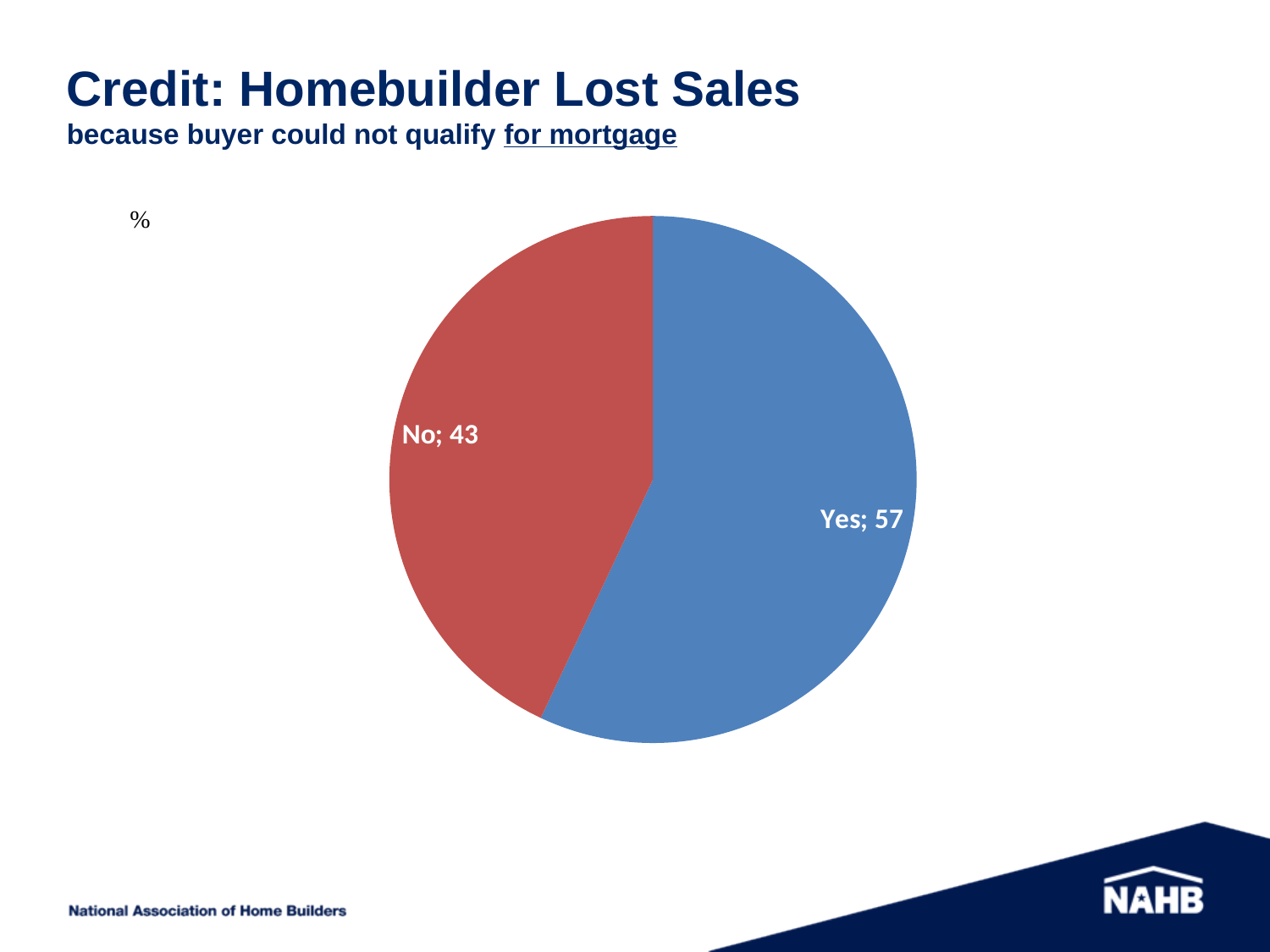
Which slice is the smallest? No Which is larger, the "Yes" slice or the "No" slice? Yes What is the difference between the "Yes" and "No" values? 14 How many slices does the pie chart have? 2 What colour is the "No" slice? red What is the value for the "No" slice? 43 What share of the pie does the "Yes" slice represent? 57% Which slice is the largest? Yes What is the title of the slide containing the chart? Credit: Homebuilder Lost Sales What is the value for the "Yes" slice? 57 What share of the pie does the "No" slice represent? 43% What kind of chart is shown on the slide? pie chart